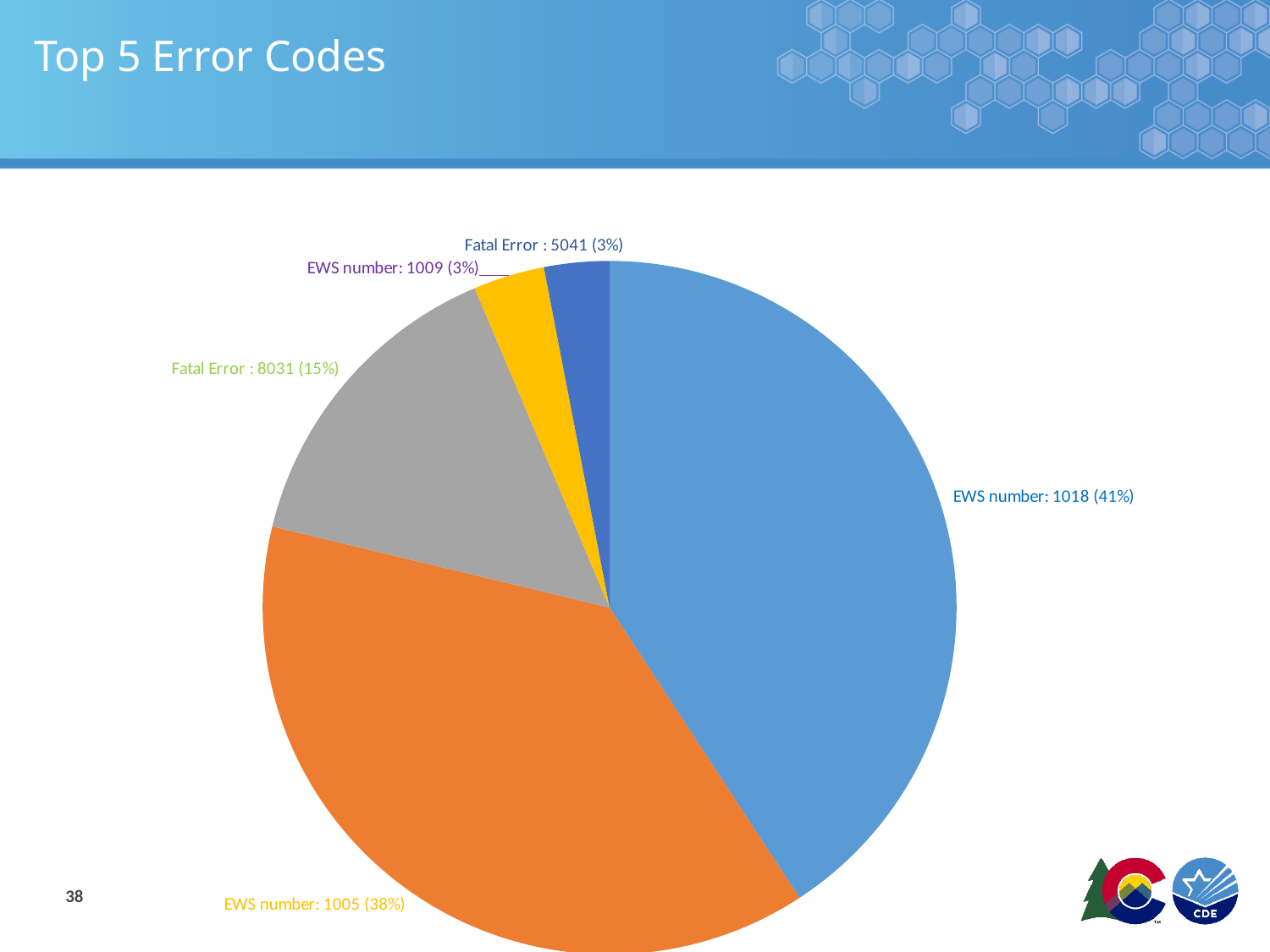
What is the title of the slide containing the pie chart? Top 5 Error Codes What share of the pie does EWS number: 1005 represent? 38% Which error code has the largest slice of the pie? EWS number: 1018 What share of the pie does EWS number: 1018 represent? 41% What share of the pie does Fatal Error : 5041 represent? 3% Which is larger, the share for EWS number: 1005 or the share for Fatal Error : 8031? EWS number: 1005 What kind of chart is shown on the slide? pie chart What is the combined share of EWS number: 1018 and EWS number: 1005? 79% What is the difference in percentage points between the shares of EWS number: 1018 and EWS number: 1005? 3 percentage points How many slices does the pie chart have? 5